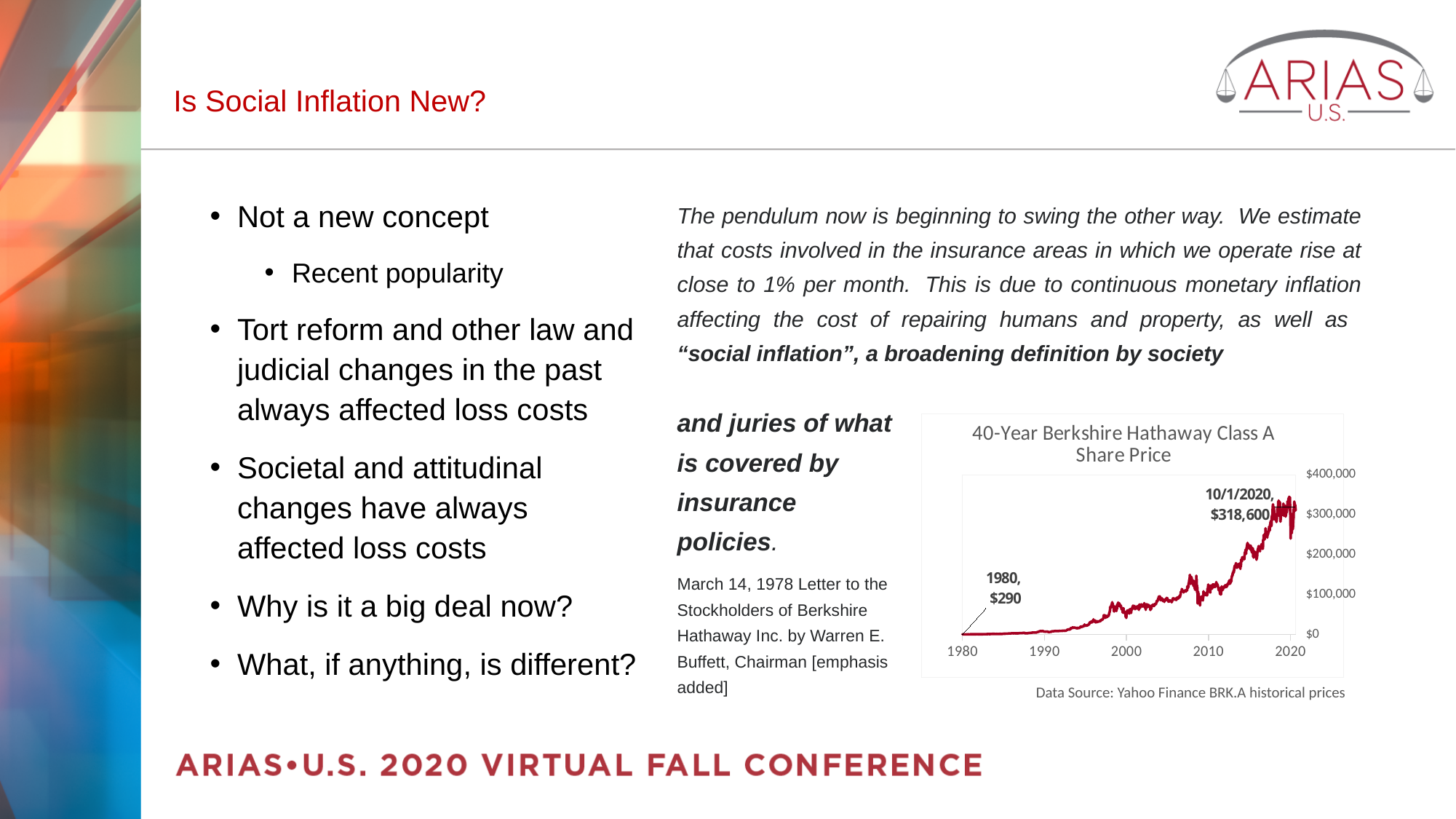
What data source is cited below the chart? Yahoo Finance BRK.A historical prices What kind of chart is shown on the slide? line chart What was the Berkshire Hathaway Class A share price in 1980 according to the chart's data label? $290 What is the title of the chart on the slide? 40-Year Berkshire Hathaway Class A Share Price Is the share price in 2000 greater or less than $100,000? less Is the labelled share price on 10/1/2020 greater or less than $300,000? greater Is the share price in 1990 greater or less than $100,000? less Does the share price generally rise or fall from 1980 to 2020 on the chart? rise What share price is labelled for 10/1/2020 on the chart? $318,600 Which is larger: the labelled share price in 1980 or the labelled share price on 10/1/2020? 10/1/2020 What is the difference between the labelled share price on 10/1/2020 and the labelled share price in 1980? $318,310